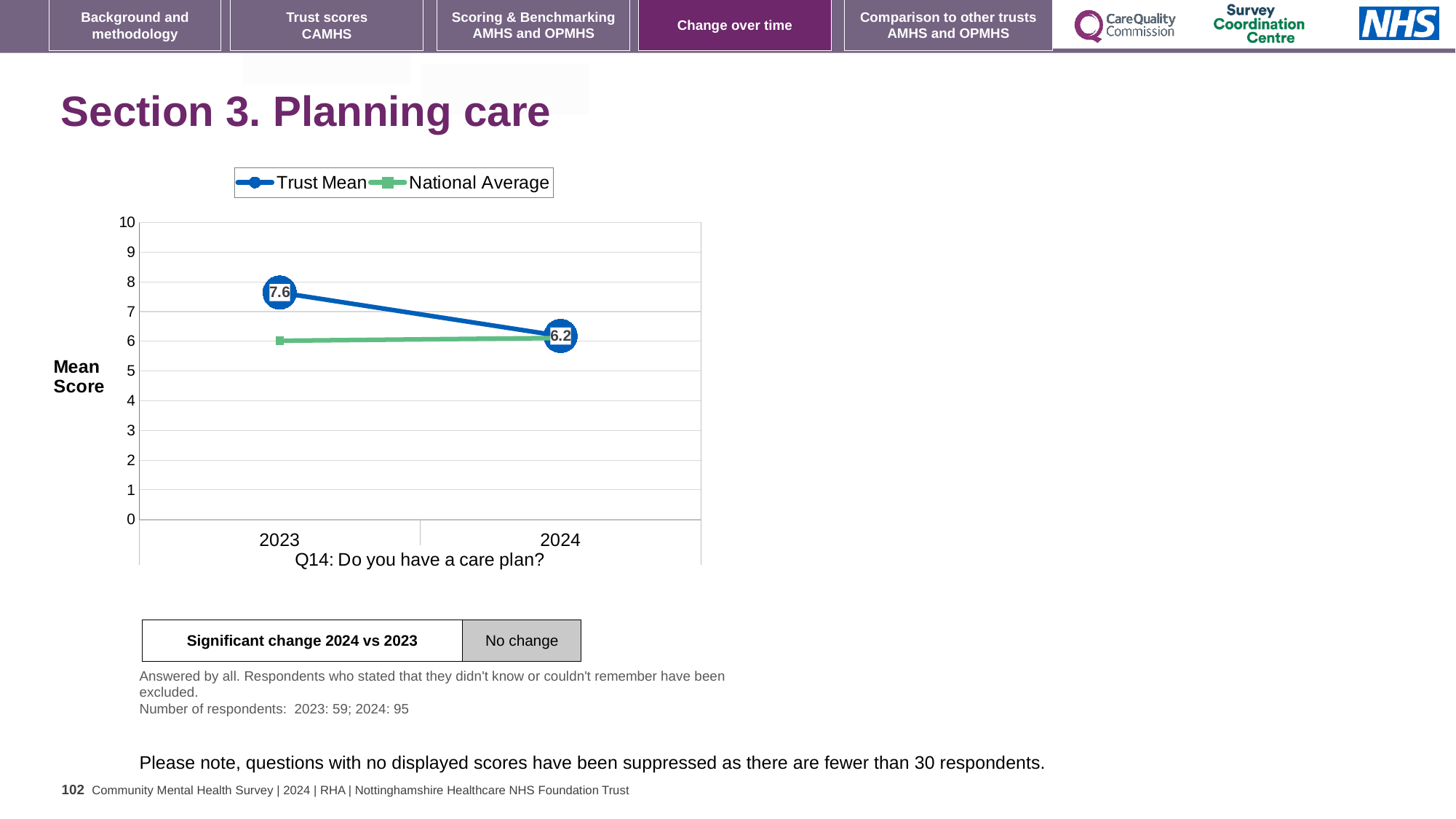
What is the Trust Mean score for 2023? 7.6 What question is the chart about, as labelled on the x axis? Q14: Do you have a care plan? Does the Trust Mean score rise or fall from 2023 to 2024? fall What is the Trust Mean score for 2024? 6.2 Is the National Average value for 2023 greater or less than 7? less How many series does the chart legend list? 2 What kind of chart is shown on the slide? line chart How many years are shown on the x axis of the chart? 2 By how much did the Trust Mean score change from 2023 to 2024? 1.4 Is the National Average value for 2024 greater or less than 5? greater In 2023, which series has the higher value, Trust Mean or National Average? Trust Mean Which year has the higher Trust Mean score, 2023 or 2024? 2023